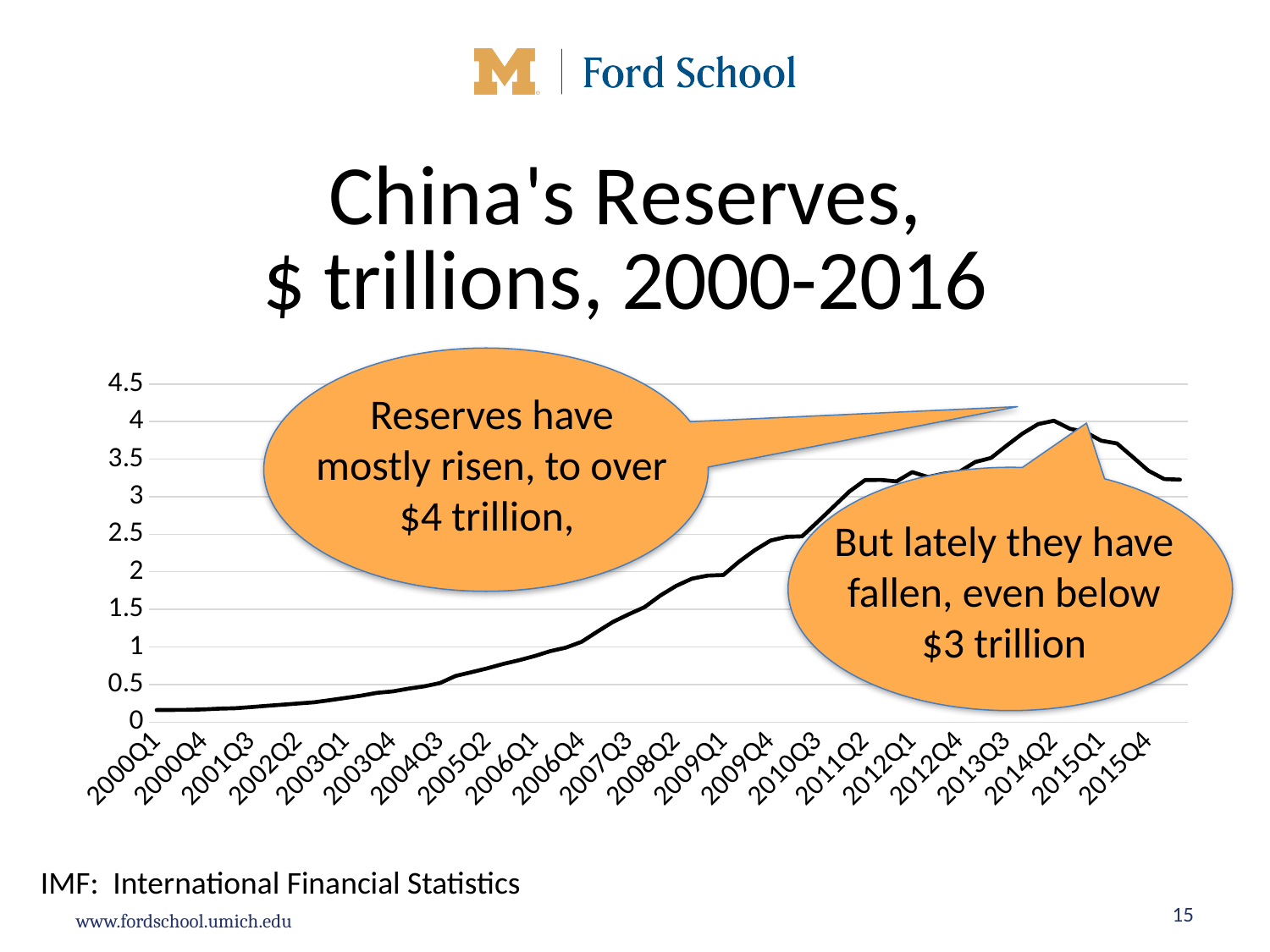
Overall, do China's reserves rise or fall from 2000Q1 to 2014Q2? rise Is the value for 2000Q1 greater or less than 0.5? less How many data series are plotted on the chart? 1 Is the value for 2010Q3 greater or less than 3? less Is the value for 2014Q2 greater or less than 3.5? greater Around which quarter do China's reserves reach their highest value? 2014Q2 Which is larger, the value for 2009Q1 or the value for 2012Q1? 2012Q1 What is the title of the chart? China's Reserves, $ trillions, 2000-2016 Do China's reserves rise or fall from 2014Q2 to 2015Q4? fall Which quarter has the lowest value of China's reserves? 2000Q1 What kind of chart is shown on the slide? line chart